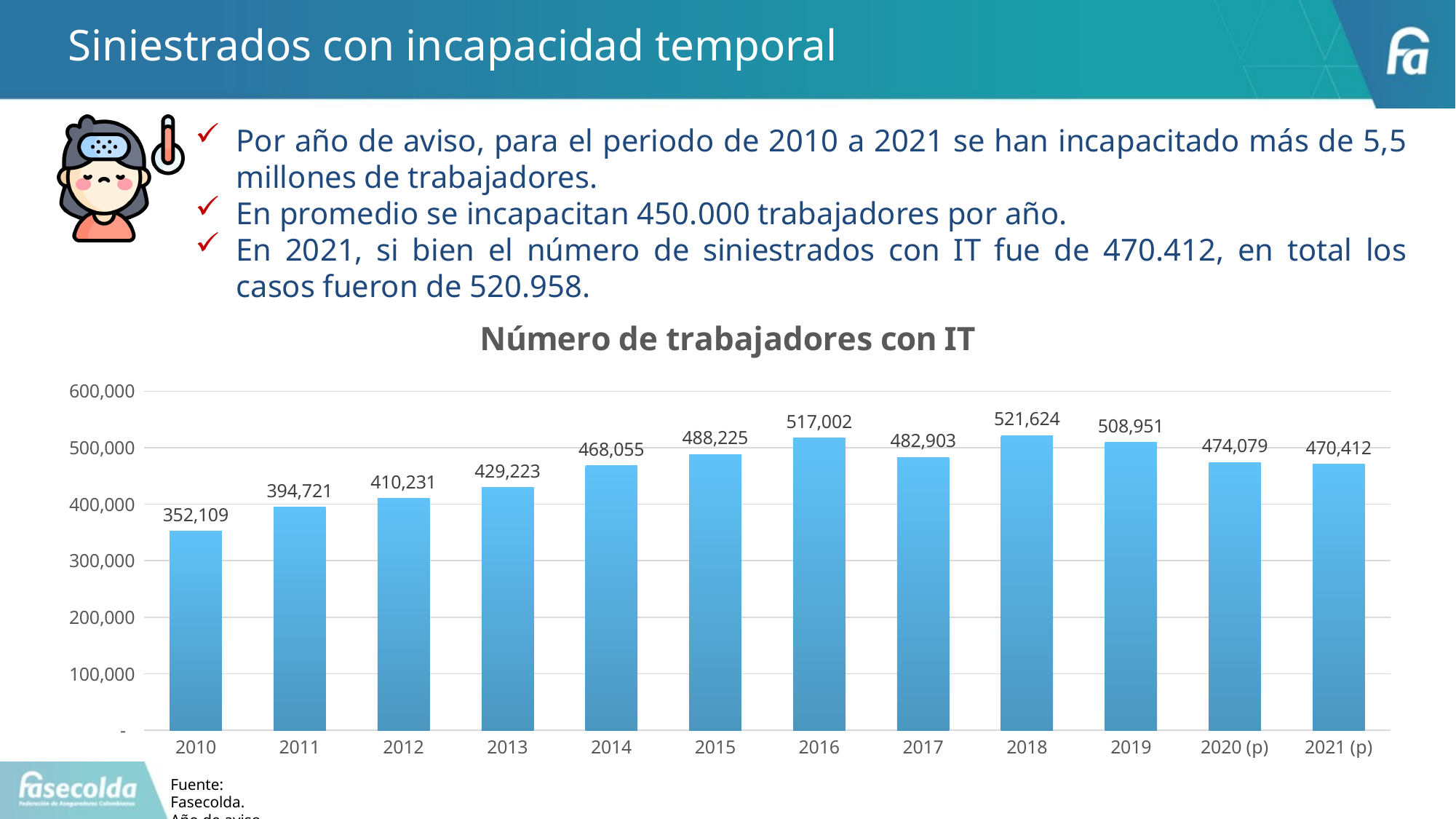
What is the value for 2010 in the chart 'Número de trabajadores con IT'? 352,109 Which year has the lowest number of workers with IT? 2010 Which is larger, the value for 2015 or the value for 2017? 2015 How many years are shown on the x axis of the chart? 12 What is the difference between the values for 2018 and 2010? 169,515 What is the difference between the values for 2020 (p) and 2021 (p)? 3,667 Is the value for 2013 greater or less than 400,000? greater What is the title of the chart? Número de trabajadores con IT What is the value for 2016 in the chart? 517,002 Which year has the highest number of workers with IT? 2018 What is the value for 2021 (p) in the chart? 470,412 What kind of chart is shown on the slide? Bar chart